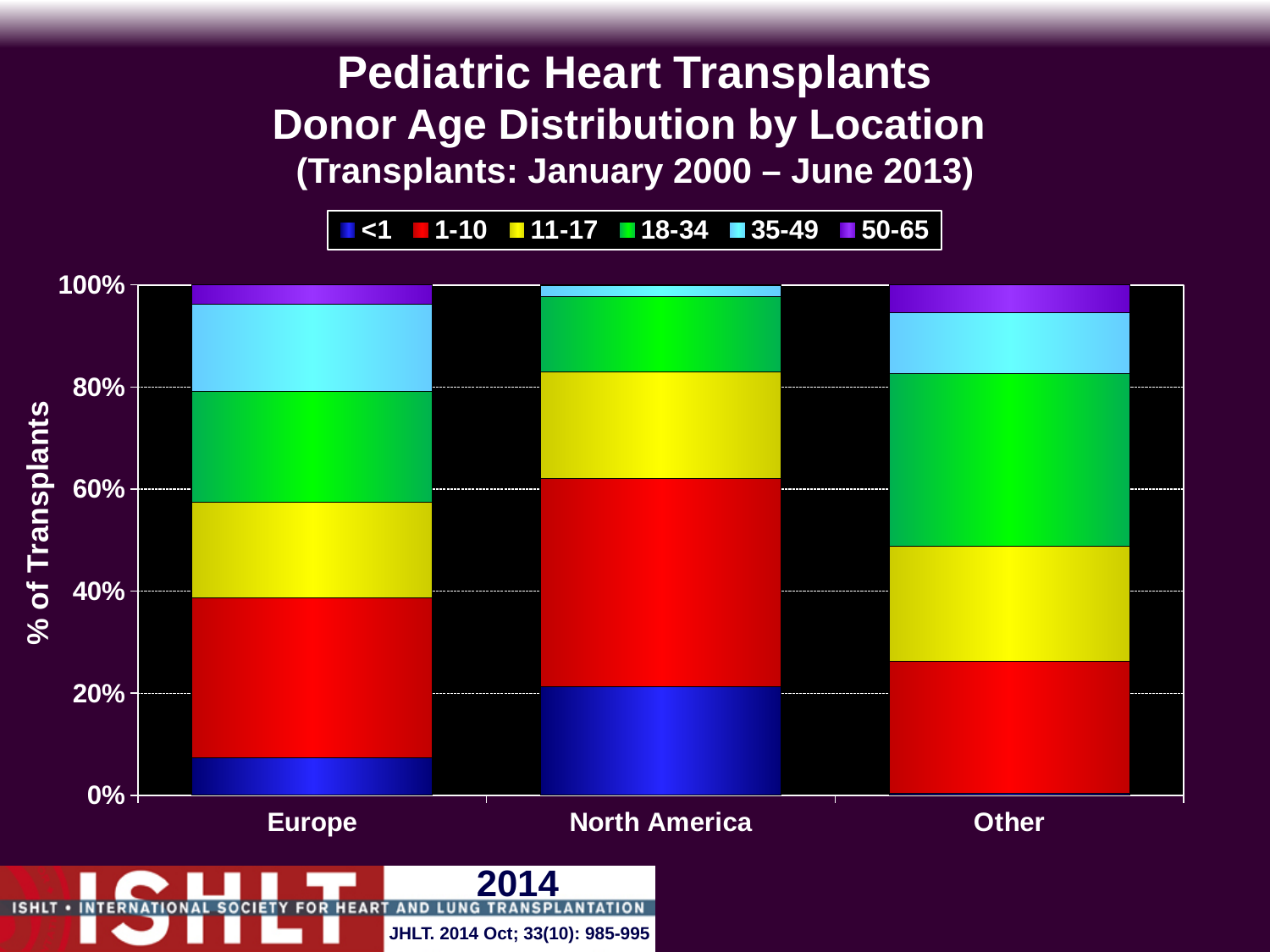
Is the share of donors aged 35-49 for Europe greater or less than 20%? less Which location has the largest share of donors aged <1? North America How many donor age groups does the legend list? 6 Which location has the smallest share of donors aged 35-49? North America Which location has the largest share of donors aged 1-10? North America How many locations are shown on the x axis? 3 What kind of chart is shown on the slide? Stacked bar chart Which location has the largest share of donors aged 18-34? Other Is the share of donors aged 1-10 for Europe greater or less than 20%? greater What is the label on the y axis? % of Transplants What does each stacked bar total? 100% Which donor age group is shown in red in the legend? 1-10